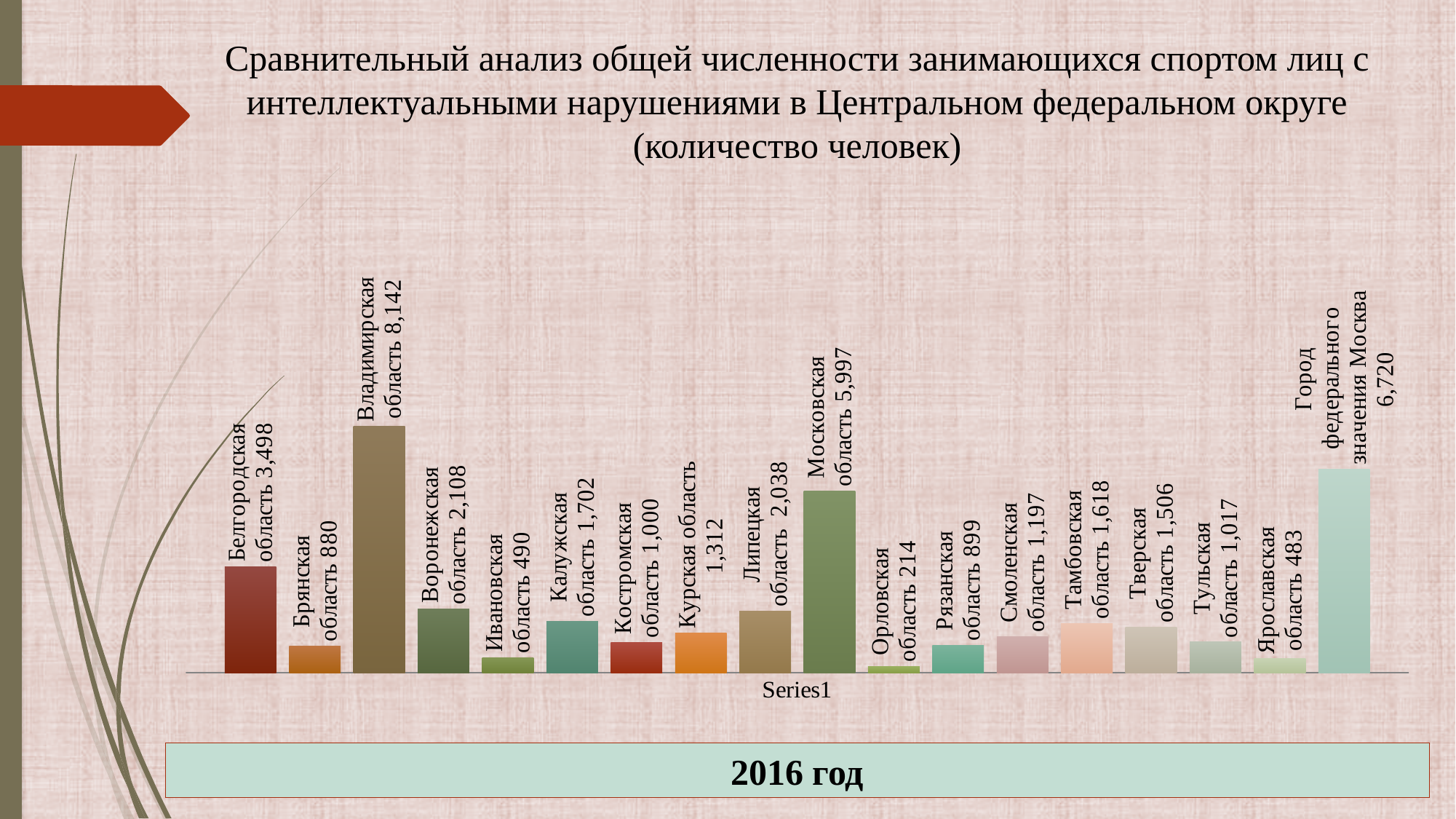
What is the value for Орловская область? 214 What year is indicated in the box below the chart? 2016 год Which is larger, the value for Московская область or the value for Город федерального значения Москва? Город федерального значения Москва What is the difference between the values for Белгородская область and Брянская область? 2,618 Which region has the lowest value? Орловская область How many regions are shown in the chart? 18 What kind of chart is shown on the slide? Bar chart What is the value for Город федерального значения Москва? 6,720 What is the difference between the values for Владимирская область and Московская область? 2,145 Which region has the highest value? Владимирская область Which is larger, the value for Калужская область or the value for Тамбовская область? Калужская область What is the value for Владимирская область? 8,142